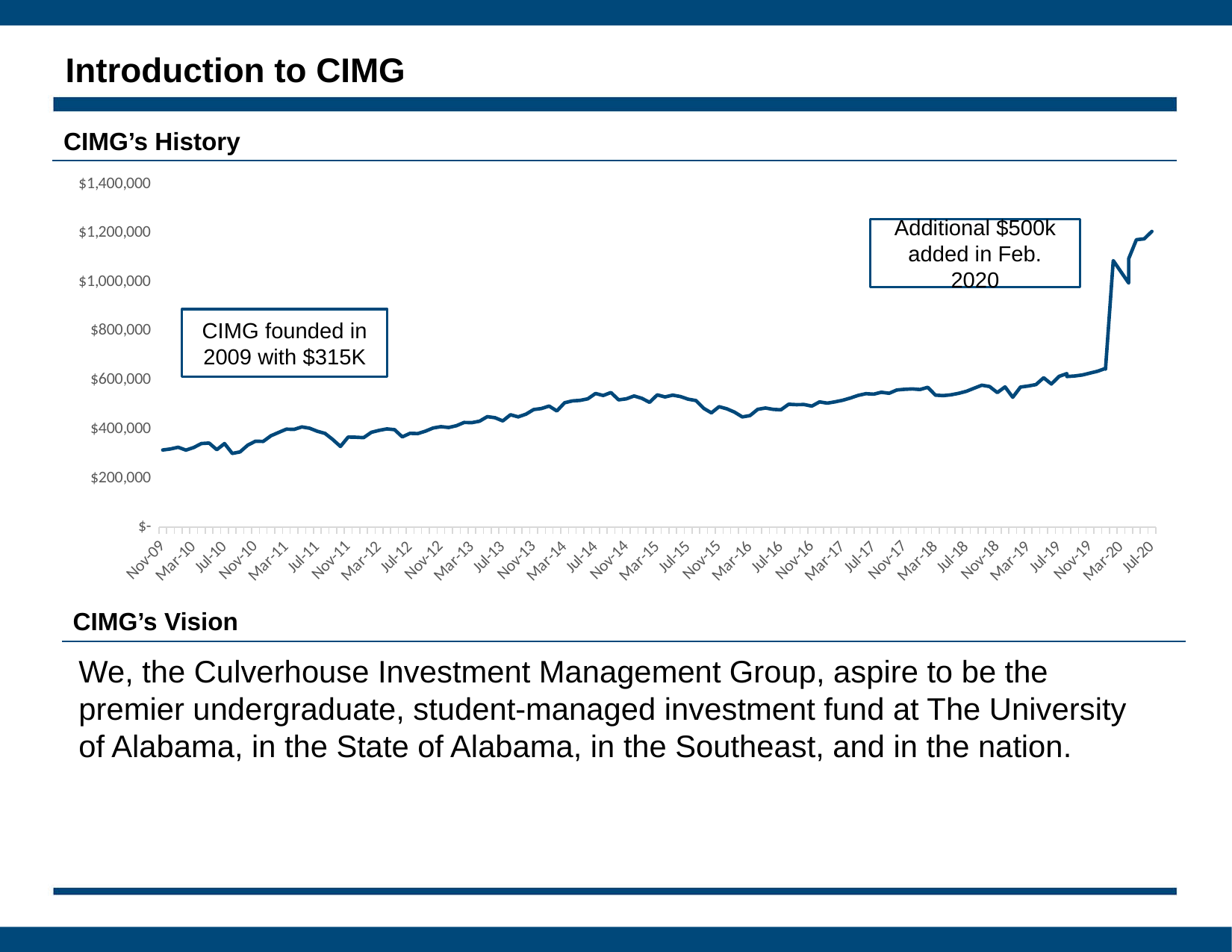
In the CIMG's History chart, is the value at Jul-14 greater or less than $400,000? greater In the CIMG's History chart, is the value at Nov-09 greater or less than $400,000? less In the CIMG's History chart, what is the last date label on the x axis? Jul-20 What kind of chart is shown under "CIMG's History"? line chart In the CIMG's History chart, what is the highest value shown on the y axis? $1,400,000 In the CIMG's History chart, is the value at Nov-19 greater or less than $800,000? less In the CIMG's History chart, what is the first date label on the x axis? Nov-09 In the CIMG's History chart, which is larger, the value at Nov-09 or the value at Mar-14? Mar-14 In the CIMG's History chart, does the value generally rise or fall from Nov-09 to Jul-20? rise In the CIMG's History chart, which is larger, the value at Jul-20 or the value at Jul-19? Jul-20